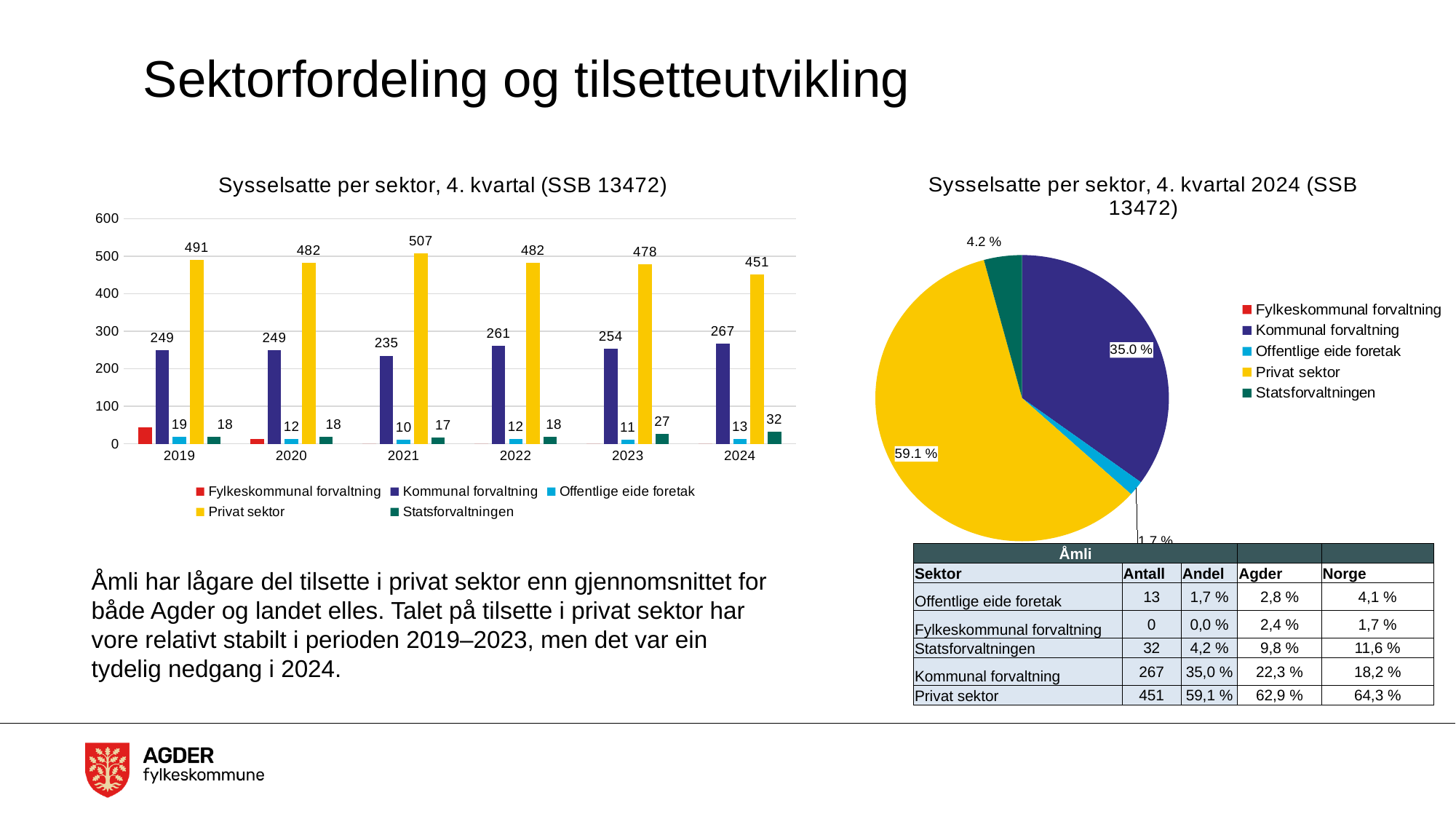
In the bar chart 'Sysselsatte per sektor, 4. kvartal (SSB 13472)', what is the value for Statsforvaltningen in 2023? 27 In the bar chart 'Sysselsatte per sektor, 4. kvartal (SSB 13472)', what is the value for Privat sektor in 2021? 507 What kind of chart is 'Sysselsatte per sektor, 4. kvartal (SSB 13472)' on the left of the slide? Bar chart In the bar chart 'Sysselsatte per sektor, 4. kvartal (SSB 13472)', which is larger in 2022: Kommunal forvaltning or Privat sektor? Privat sektor In the bar chart 'Sysselsatte per sektor, 4. kvartal (SSB 13472)', in which year is Privat sektor lowest? 2024 In the bar chart 'Sysselsatte per sektor, 4. kvartal (SSB 13472)', in which year is Privat sektor highest? 2021 In the bar chart 'Sysselsatte per sektor, 4. kvartal (SSB 13472)', what is the difference between Privat sektor in 2023 and in 2024? 27 In the pie chart 'Sysselsatte per sektor, 4. kvartal 2024 (SSB 13472)', what share does Kommunal forvaltning have? 35.0 % In the pie chart 'Sysselsatte per sektor, 4. kvartal 2024 (SSB 13472)', what share does Privat sektor have? 59.1 % In the bar chart 'Sysselsatte per sektor, 4. kvartal (SSB 13472)', how many years are shown on the x axis? 6 In the bar chart 'Sysselsatte per sektor, 4. kvartal (SSB 13472)', how many series does the legend list? 5 In the bar chart 'Sysselsatte per sektor, 4. kvartal (SSB 13472)', what is the value for Kommunal forvaltning in 2024? 267